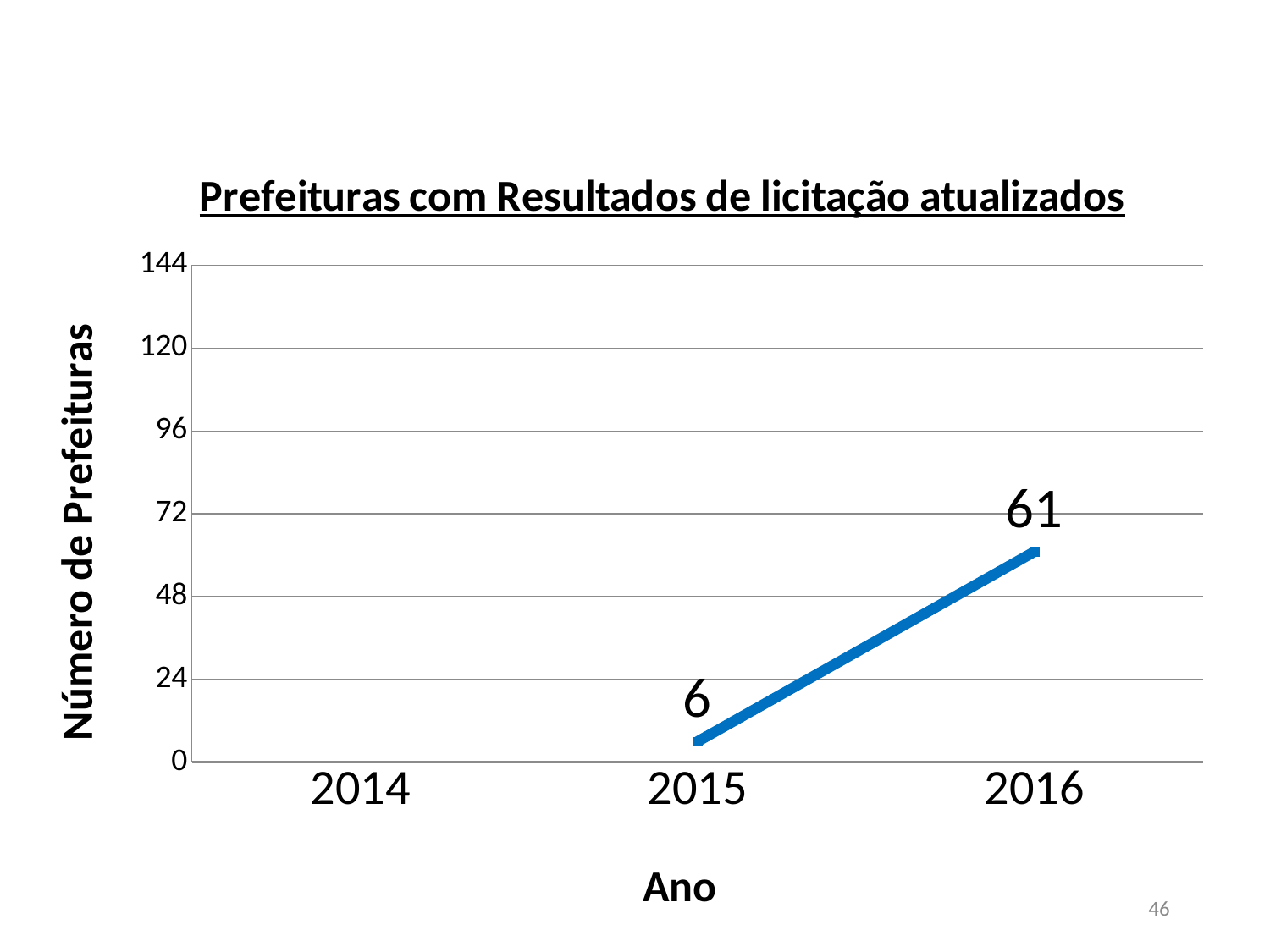
What is the title of the chart? Prefeituras com Resultados de licitação atualizados Which year has the highest value? 2016 Which year with a plotted value has the lowest value? 2015 Is the value for 2016 greater or less than 48? greater What is the value for 2015? 6 Do the values rise or fall from 2015 to 2016? rise Is the value for 2015 greater or less than 24? less What is the value for 2016? 61 What is the difference between the values for 2016 and 2015? 55 How many years are shown on the x axis? 3 Which is larger, the value for 2015 or the value for 2016? 2016 What kind of chart is this? line chart